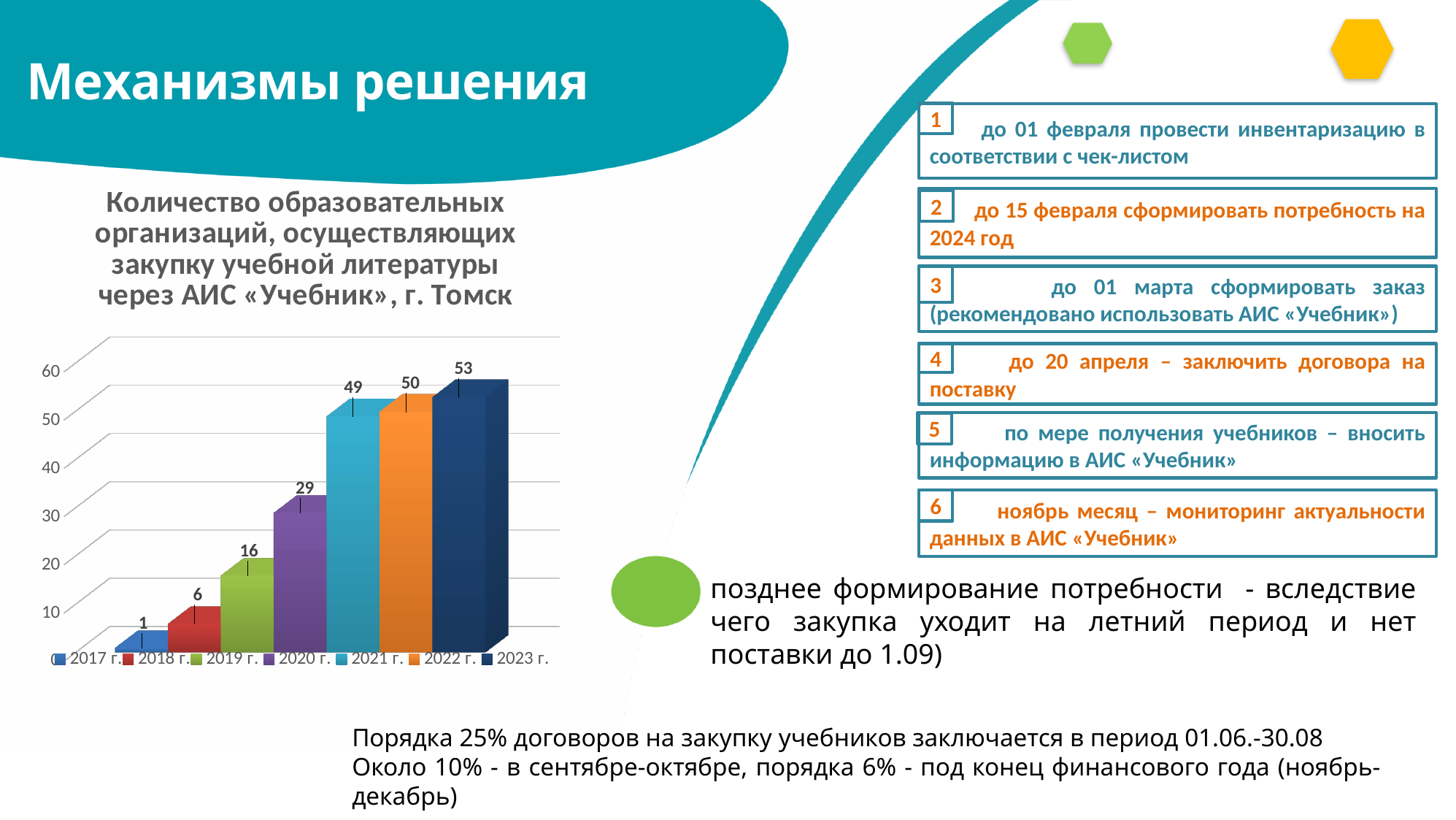
What is the value for 2017 г. in the chart? 1 Which is larger, the value for 2018 г. or the value for 2019 г.? 2019 г. What is the value for 2021 г. in the chart? 49 Is the value for 2020 г. greater or less than 20? greater Which year has the highest value in the chart? 2023 г. What is the difference between the values for 2023 г. and 2020 г.? 24 What is the value for 2019 г. in the chart? 16 Do the values rise or fall from 2017 г. to 2023 г.? rise What kind of chart is shown on the slide? bar chart What is the difference between the values for 2020 г. and 2019 г.? 13 How many years (bars) are shown in the chart? 7 Which year has the lowest value in the chart? 2017 г.